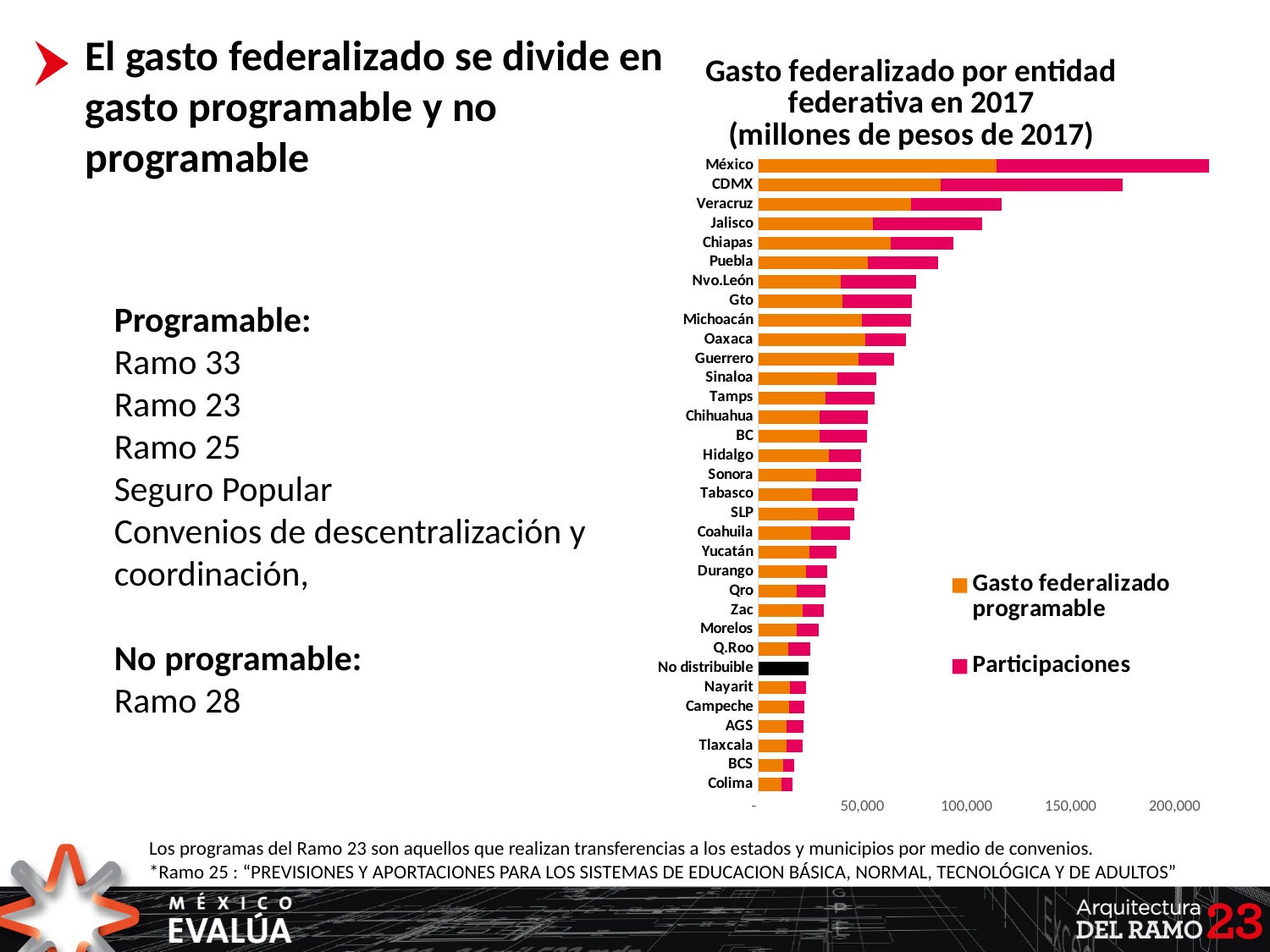
Which has a larger total gasto federalizado, CDMX or Veracruz? CDMX Which entity has the highest total gasto federalizado in the chart? México What is the title of the chart? Gasto federalizado por entidad federativa en 2017 (millones de pesos de 2017) Is the total value for México greater or less than 200,000? greater Is the total value for Chiapas greater or less than 100,000? less Is the total value for CDMX greater or less than 150,000? greater Which legend entry is shown in pink/magenta? Participaciones How many series does the chart legend list? 2 What kind of chart is shown on the slide? bar chart Do the total bar lengths increase or decrease going from the top of the chart (México) to the bottom (Colima)? decrease Which entity has the lowest total gasto federalizado in the chart? Colima